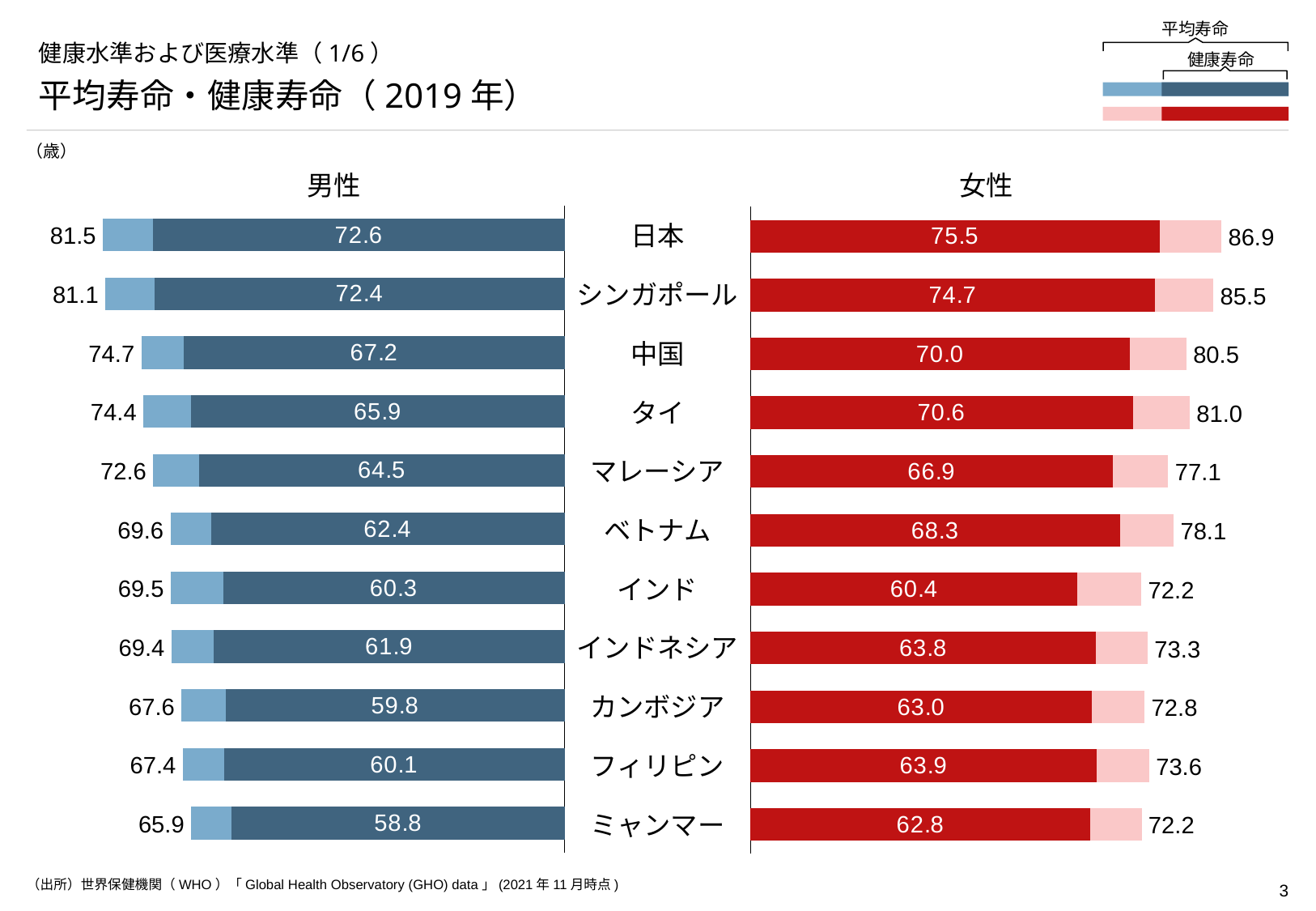
How many countries are shown in the 男性 chart? 11 In the 男性 chart, which is larger, the 健康寿命 for インド or for インドネシア? インドネシア What colour are the 女性 bars on the slide? Red In the 女性 chart, which is larger, the 健康寿命 for タイ or for 中国? タイ In the 女性 chart, what is the difference between the 平均寿命 and 健康寿命 for 日本? 11.4 In the 女性 chart, what is the 健康寿命 value for シンガポール? 74.7 In the 男性 chart, what is the difference between the 平均寿命 of 日本 and シンガポール? 0.4 In the 男性 chart, what is the 平均寿命 value for 日本? 81.5 What kind of chart is used on this slide? Bar chart In the 男性 chart, what is the 健康寿命 value for ベトナム? 62.4 In the 女性 chart, which country has the highest 平均寿命? 日本 In the 男性 chart, which country has the lowest 健康寿命? ミャンマー